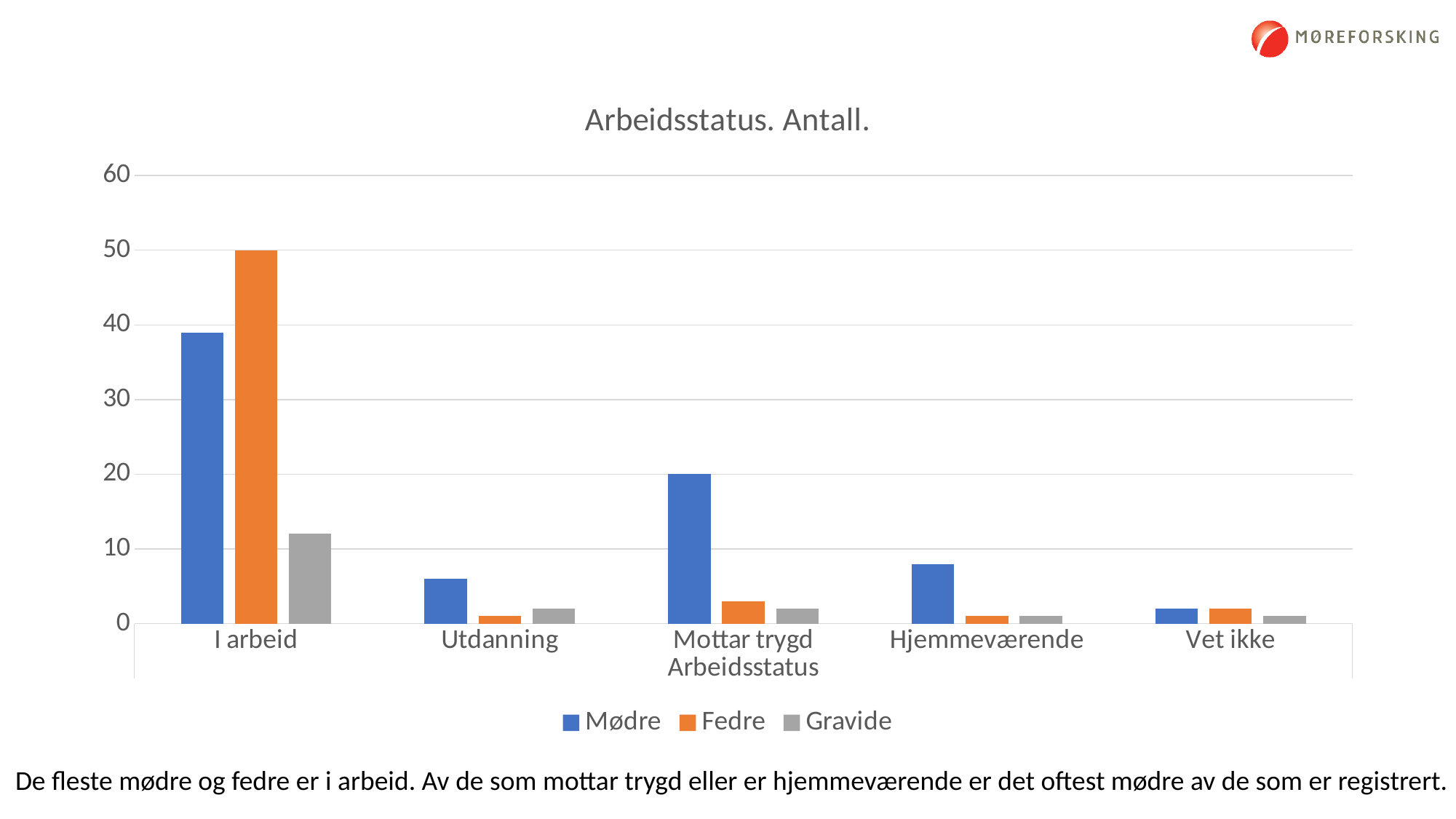
Which series has the highest bar in the I arbeid category? Fedre What is the title of the chart? Arbeidsstatus. Antall. What is the value for Mødre in the Mottar trygd category? 20 How many series does the legend list? 3 In the Mottar trygd category, which is larger, Mødre or Fedre? Mødre Is the value for Gravide in the I arbeid category greater or less than 10? greater In which category does the Mødre series have its lowest value? Vet ikke Is the value for Mødre in the Hjemmeværende category greater or less than 10? less What is the value for Fedre in the I arbeid category? 50 How many categories are shown on the x axis? 5 Is the value for Mødre in the I arbeid category greater or less than 30? greater What kind of chart is shown on the slide? Bar chart